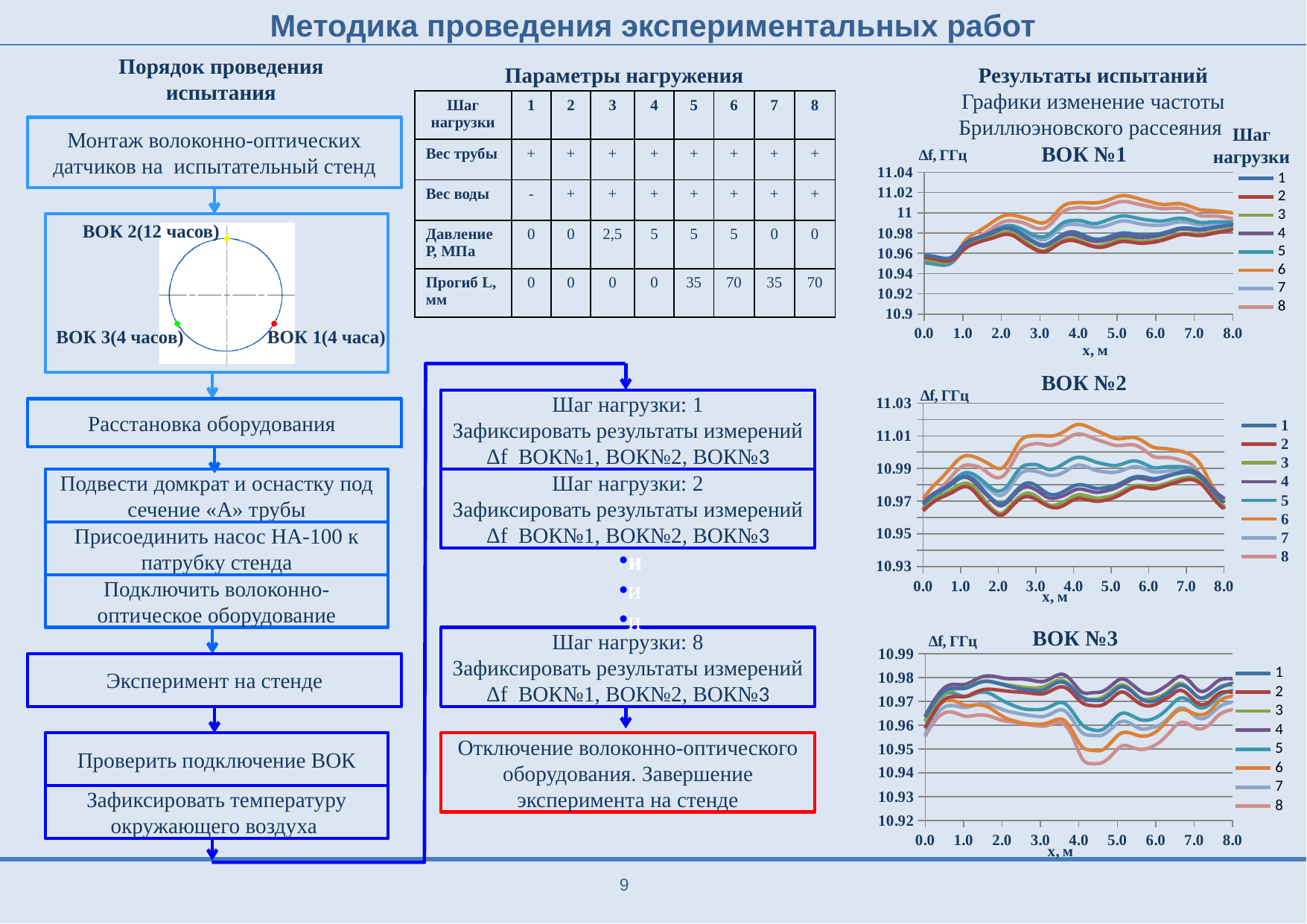
In the ВОК №1 chart, is the value of series 2 at x = 0.0 greater or less than 10.98? less In the ВОК №1 chart, is the value of series 6 at x = 4.0 greater or less than 10.98? greater In the ВОК №2 chart, is the value of series 2 at x = 0.0 greater or less than 10.99? less How many series does the legend of the ВОК №3 chart list? 8 What is the x-axis label on the ВОК №2 chart? x, м What is the title of the legend on the ВОК №1 chart? Шаг нагрузки In the ВОК №1 chart, does series 6 rise or fall from x = 0.0 to x = 5.0? rise How many series does the legend of the ВОК №2 chart list? 8 What kind of chart is the ВОК №1 chart? line chart